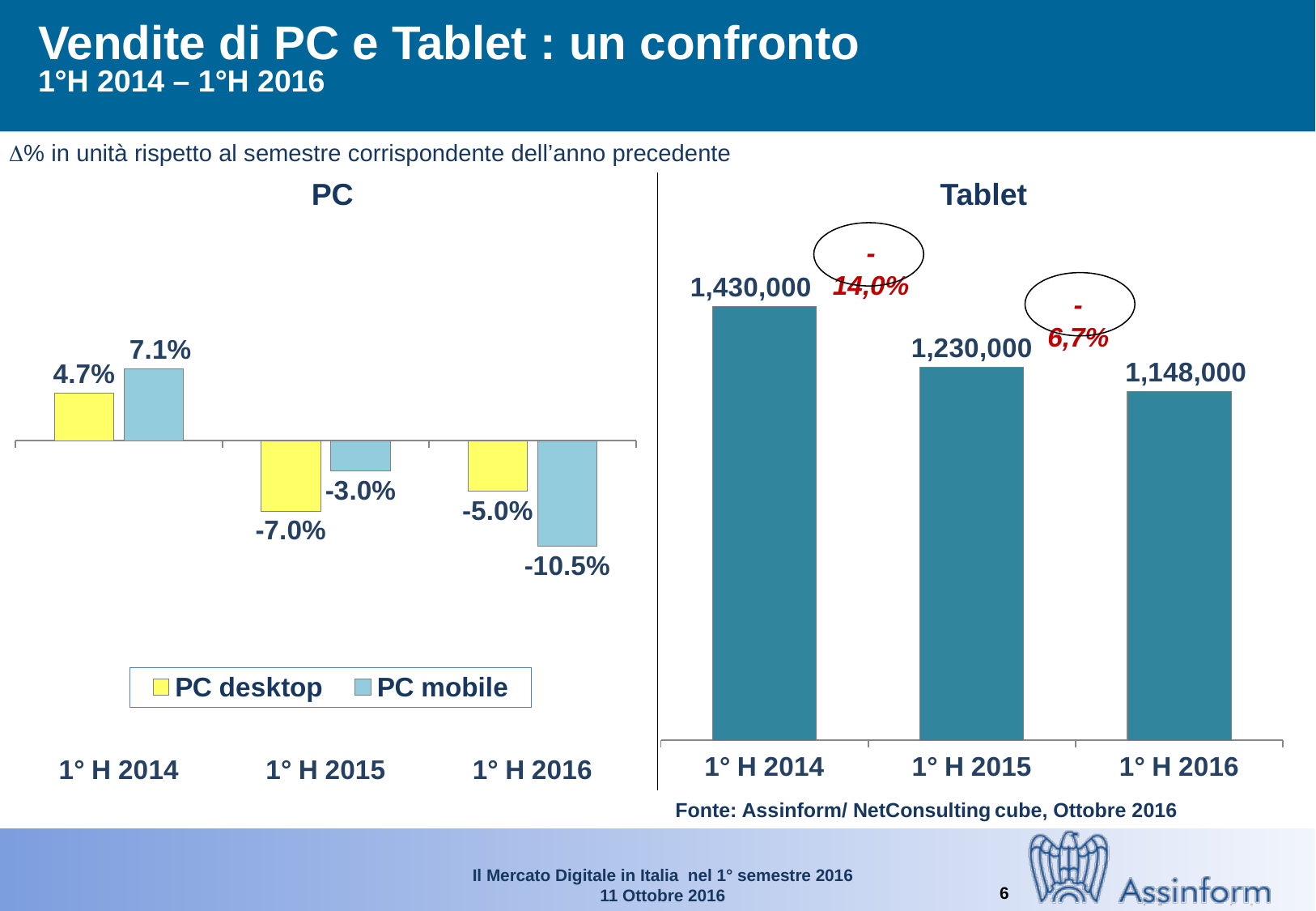
In the PC chart, which category has the lowest PC desktop value? 1° H 2015 In the PC chart, what is the value for PC desktop in 1° H 2014? 4.7% In the PC chart, what is the value for PC mobile in 1° H 2016? -10.5% In the Tablet chart, what is the value for 1° H 2015? 1,230,000 In the Tablet chart, which category has the lowest value? 1° H 2016 In the PC chart, what is the value for PC desktop in 1° H 2015? -7.0% In the PC chart, how many series does the legend list? 2 In the PC chart, what is the difference between the PC mobile value and the PC desktop value in 1° H 2014? 2.4% In the PC chart, which category has the highest PC mobile value? 1° H 2014 What kind of chart is the Tablet chart? bar chart In the Tablet chart, do the values rise or fall from 1° H 2014 to 1° H 2016? fall In the Tablet chart, what is the difference between the 1° H 2014 value and the 1° H 2016 value? 282,000